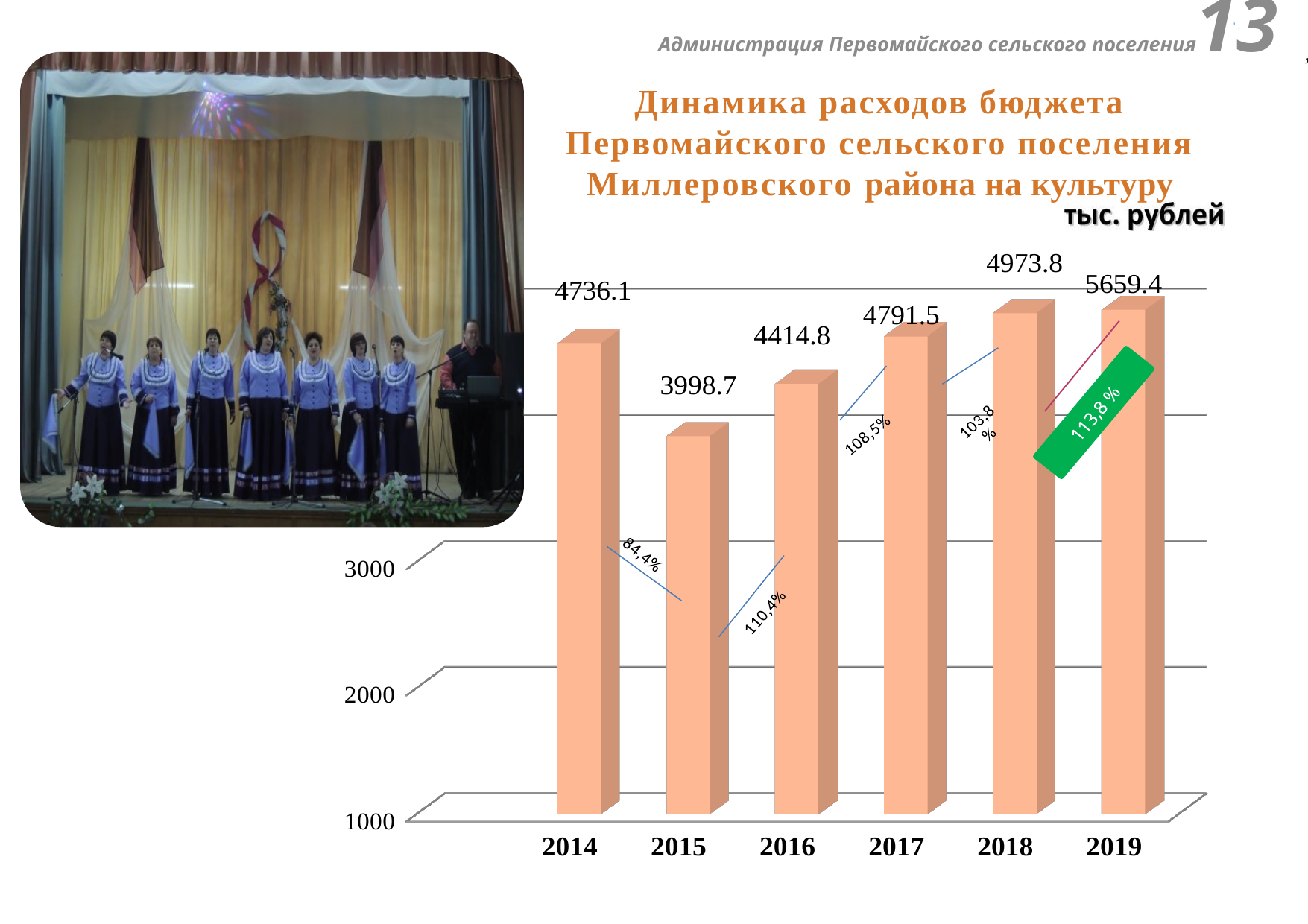
Which year has the lowest expenditure on culture? 2015 What is the value shown for 2015? 3998.7 What is the budget expenditure on culture for 2014? 4736.1 What is the value shown for 2017? 4791.5 What is the difference between the 2019 and 2018 values? 685.6 How many years are shown on the x axis? 6 Which is larger, the value for 2014 or the value for 2016? 2014 Is the value for 2015 greater or less than 3000? greater What is the value shown for 2019? 5659.4 What kind of chart is shown on the slide? bar chart Which year has the highest expenditure on culture? 2019 What unit of measurement is stated above the chart? тыс. рублей